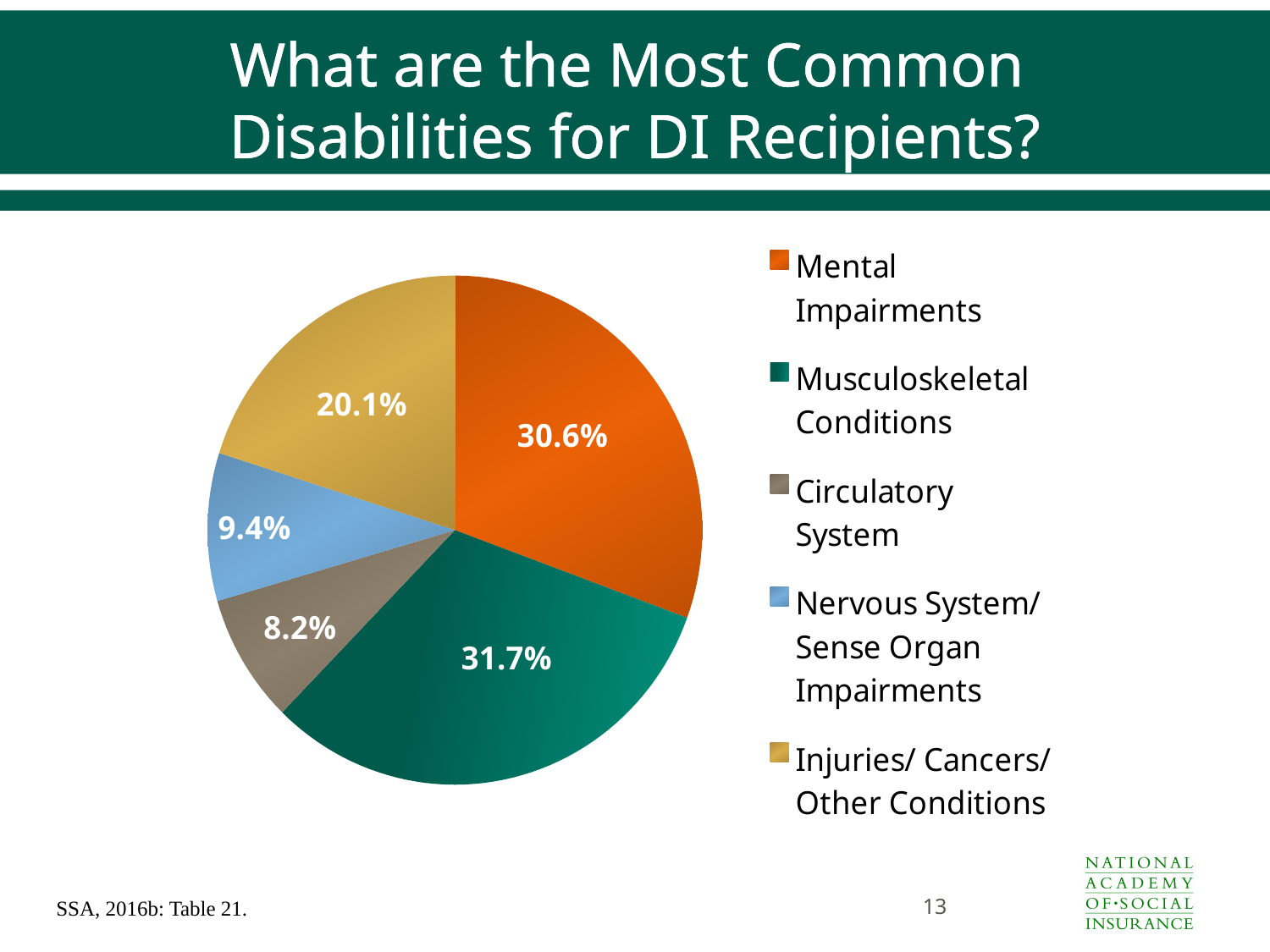
What is the value shown for Circulatory System? 8.2% What is the difference in percentage points between Musculoskeletal Conditions and Mental Impairments? 1.1 How many categories are shown in the pie chart? 5 Which category has the smallest slice of the pie? Circulatory System Which colour represents Injuries/ Cancers/ Other Conditions in the legend? Gold What share of DI recipients have Mental Impairments as their disability? 30.6% Which category has the largest slice of the pie? Musculoskeletal Conditions What percentage of the pie is Musculoskeletal Conditions? 31.7% What type of chart is shown on the slide? Pie chart What percentage is shown for Nervous System/ Sense Organ Impairments? 9.4% What share of the pie is Injuries/ Cancers/ Other Conditions? 20.1% Which is larger, the share for Nervous System/ Sense Organ Impairments or the share for Circulatory System? Nervous System/ Sense Organ Impairments